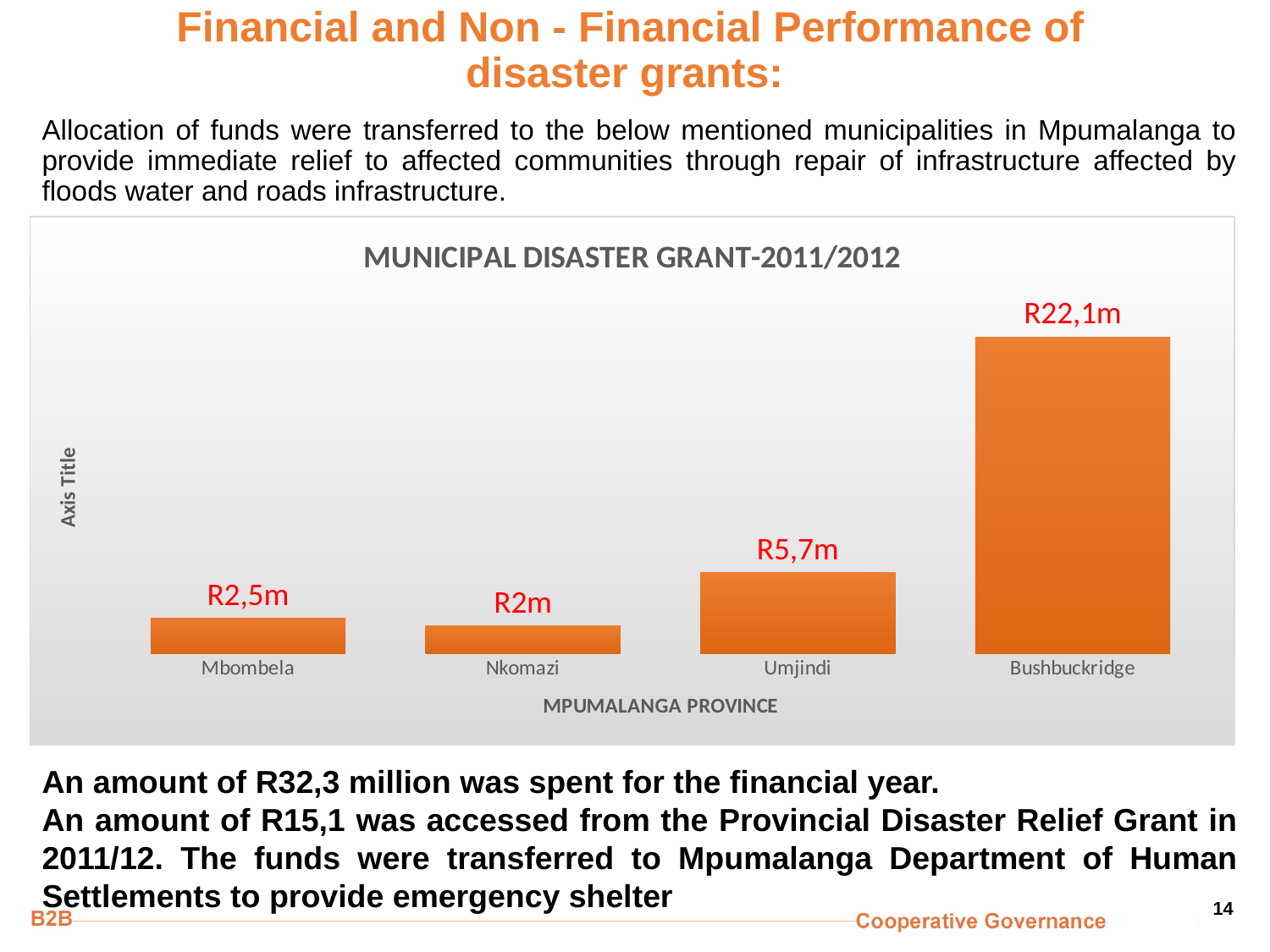
What is the title of the chart? MUNICIPAL DISASTER GRANT-2011/2012 What kind of chart is shown on the slide? Bar chart What is the difference between the values for Mbombela and Nkomazi? R0,5m How many municipalities are shown in the chart? 4 What is the value for Bushbuckridge? R22,1m What is the value for Mbombela? R2,5m What is the difference between the values for Bushbuckridge and Umjindi? R16,4m What is the value for Umjindi? R5,7m What is the value for Nkomazi? R2m Which is larger, the value for Umjindi or the value for Mbombela? Umjindi Which municipality received the lowest disaster grant? Nkomazi Which municipality received the highest disaster grant? Bushbuckridge